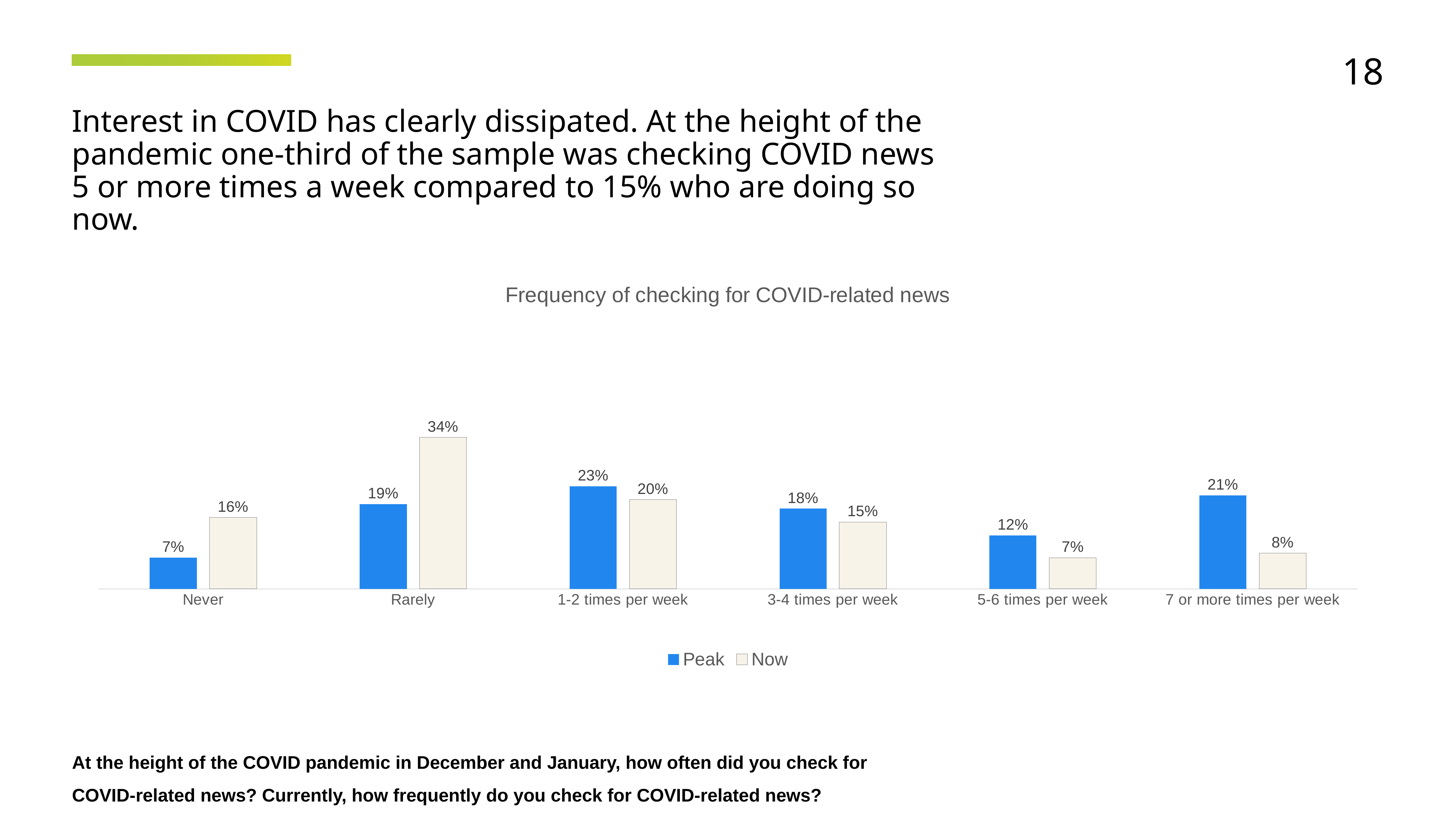
For '1-2 times per week', which is larger, the Peak value or the Now value? Peak Which category has the highest Now value? Rarely What is the Peak value for 'Rarely'? 19% What is the title of the chart? Frequency of checking for COVID-related news What is the Now value for '7 or more times per week'? 8% How many series does the legend list? 2 What is the difference between the Now and Peak values for 'Never'? 9% How many categories are shown on the x axis? 6 What kind of chart is shown on the slide? Bar chart What is the difference between the Peak and Now values for '7 or more times per week'? 13% Which category has the lowest Peak value? Never What is the Now value for '3-4 times per week'? 15%